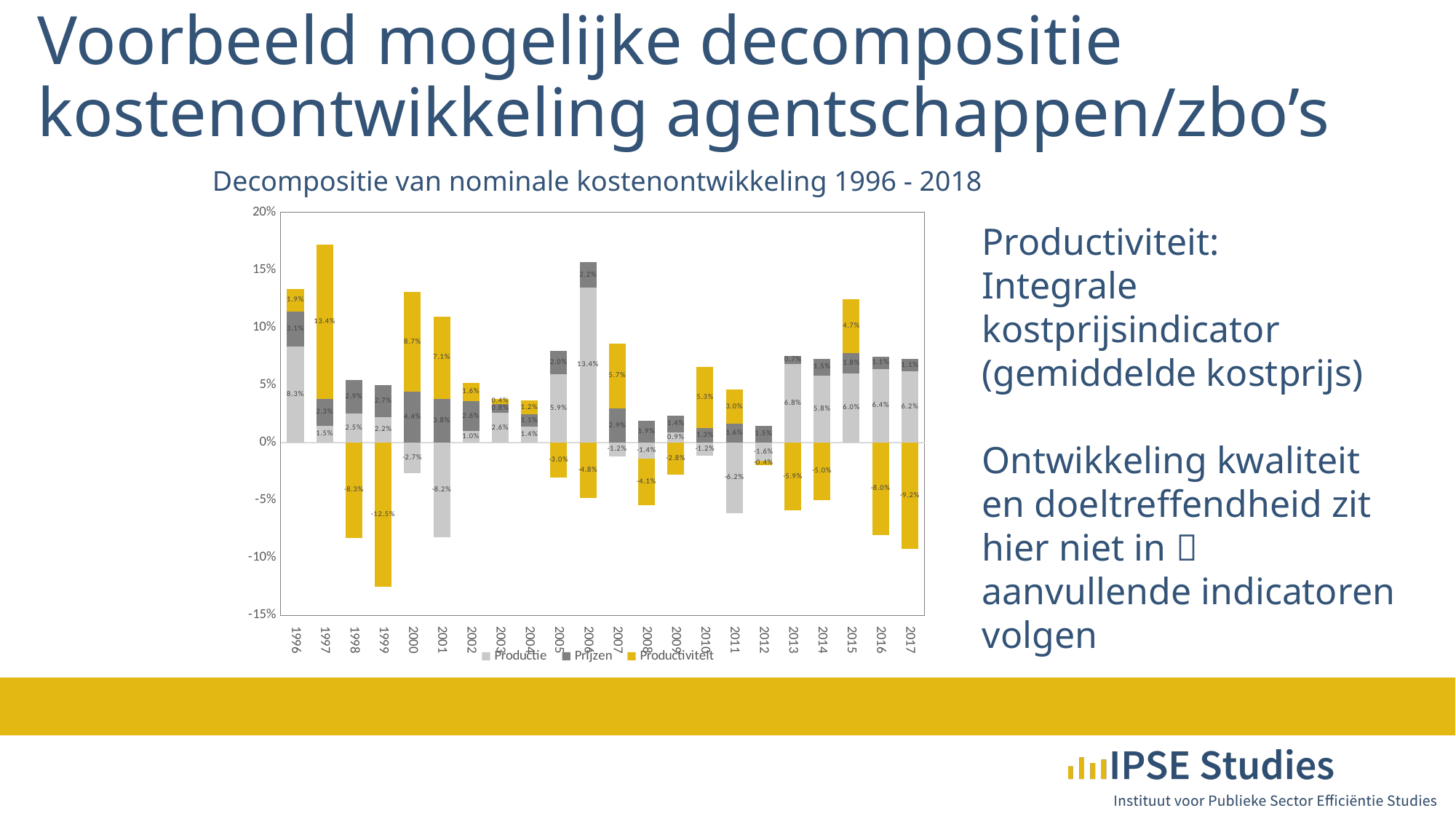
What is the title of the chart? Decompositie van nominale kostenontwikkeling 1996 - 2018 In which year is the Productiviteit value the highest? 1997 What is the Productie value for 2006? 13.4% What is the difference between the Productie values for 2016 and 2017? 0.2% How many series does the legend list? 3 What kind of chart is shown on the slide? bar chart How many years are shown on the x axis of the chart? 22 What is the Productiviteit value for 1997? 13.4% Which is larger, the Prijzen value for 1996 or the Prijzen value for 2013? 1996 What is the Prijzen value for 2000? 4.4% What is the total of the stacked bar for 1996? 13.3% In which year is the Productiviteit value the lowest? 1999